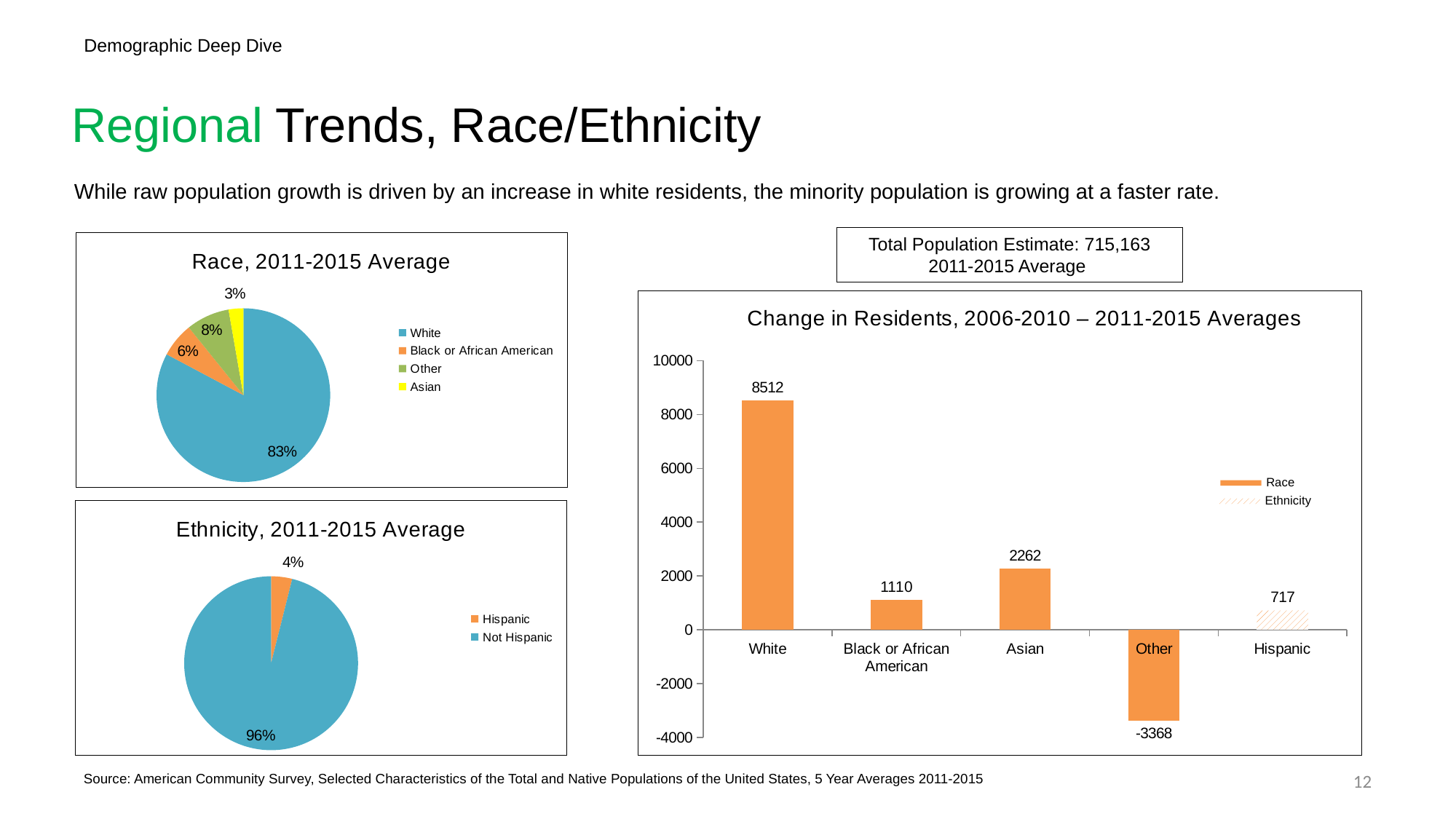
In the 'Change in Residents, 2006-2010 – 2011-2015 Averages' chart, which is larger, the value for Hispanic or the value for Black or African American? Black or African American In the 'Change in Residents, 2006-2010 – 2011-2015 Averages' chart, what is the difference between the values for Asian and Black or African American? 1152 In the 'Ethnicity, 2011-2015 Average' pie chart, what share is Hispanic? 4% In the 'Race, 2011-2015 Average' pie chart, which category has the smallest slice? Asian In the 'Race, 2011-2015 Average' pie chart, what share is Black or African American? 6% How many series does the legend of the 'Ethnicity, 2011-2015 Average' pie chart list? 2 How many categories are shown on the x axis of the 'Change in Residents, 2006-2010 – 2011-2015 Averages' chart? 5 In the 'Change in Residents, 2006-2010 – 2011-2015 Averages' chart, what is the value for Other? -3368 In the 'Change in Residents, 2006-2010 – 2011-2015 Averages' chart, what is the value for White? 8512 In the 'Change in Residents, 2006-2010 – 2011-2015 Averages' chart, which category has the lowest value? Other In the 'Race, 2011-2015 Average' pie chart, what share is White? 83% What kind of chart is 'Change in Residents, 2006-2010 – 2011-2015 Averages'? Bar chart